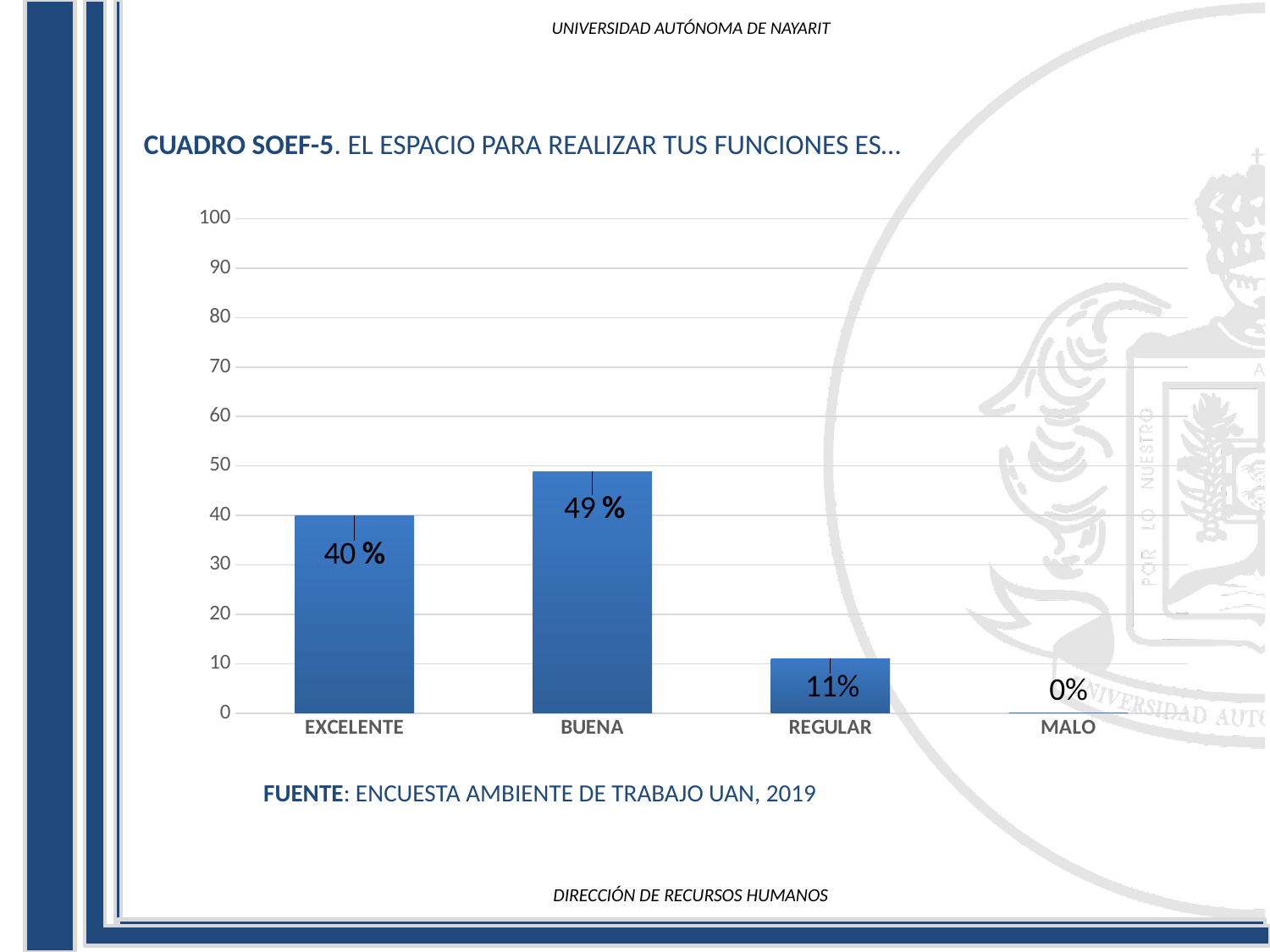
What is the value for MALO? 0% What is the difference between the values for BUENA and EXCELENTE? 9 % How many categories are shown on the x axis? 4 What kind of chart is shown on the slide? bar chart Which category has the lowest value? MALO Is the value for BUENA greater or less than 50? less What is the value for BUENA? 49 % What is the source cited below the chart? ENCUESTA AMBIENTE DE TRABAJO UAN, 2019 Which category has the highest value? BUENA What is the value for REGULAR? 11% What is the value for EXCELENTE? 40 % Which is larger, the value for EXCELENTE or the value for REGULAR? EXCELENTE